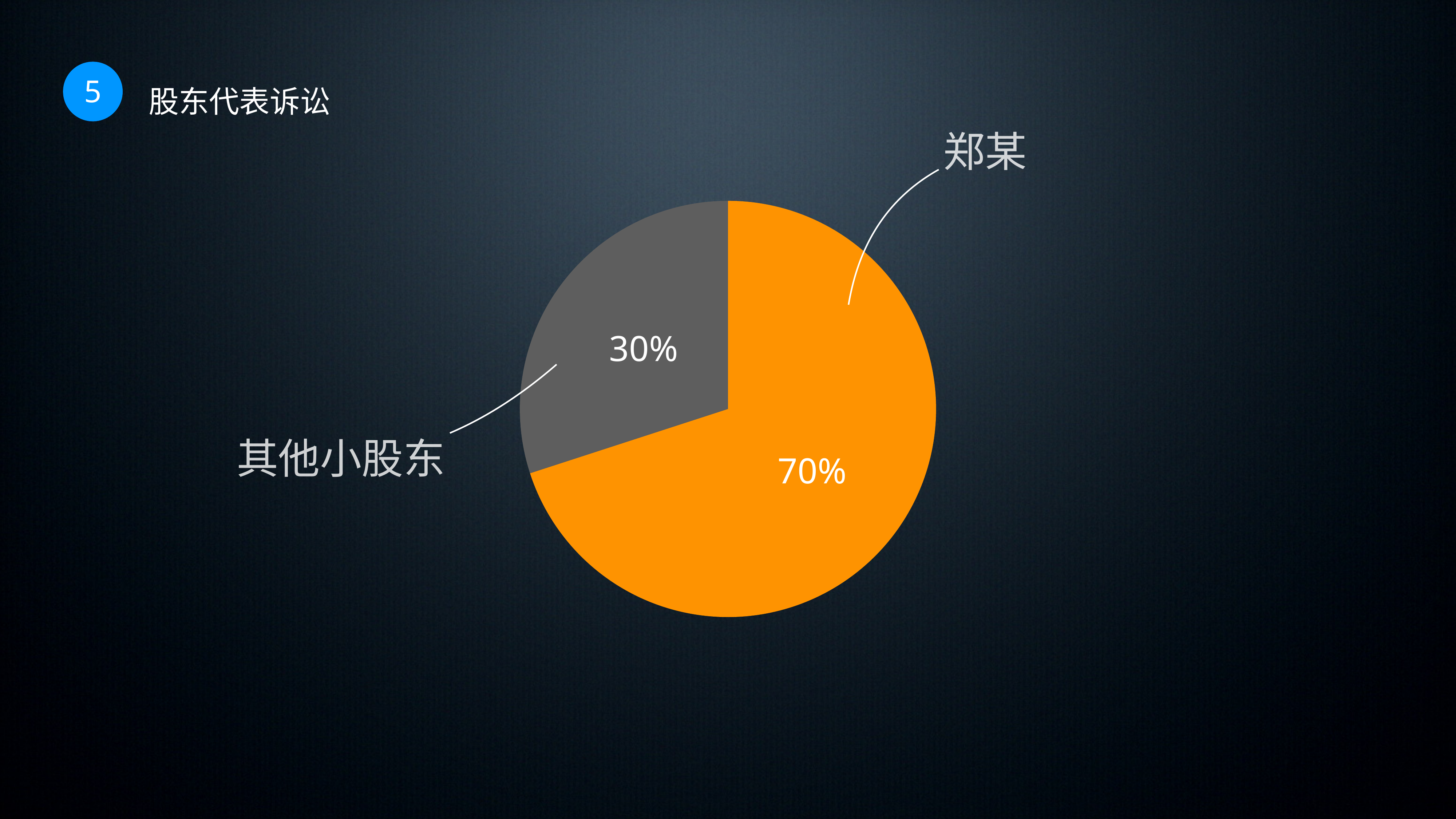
What share of the pie does 其他小股东 hold? 30% What colour is the slice for 其他小股东? grey Which slice of the pie is the largest? 郑某 How many slices does the pie chart have? 2 Which is larger, the share for 郑某 or the share for 其他小股东? 郑某 What kind of chart is shown on the slide? pie chart What colour is the slice for 郑某? orange What share of the pie does 郑某 hold? 70% Which slice of the pie is the smallest? 其他小股东 What is the difference in percentage points between the 郑某 slice and the 其他小股东 slice? 40